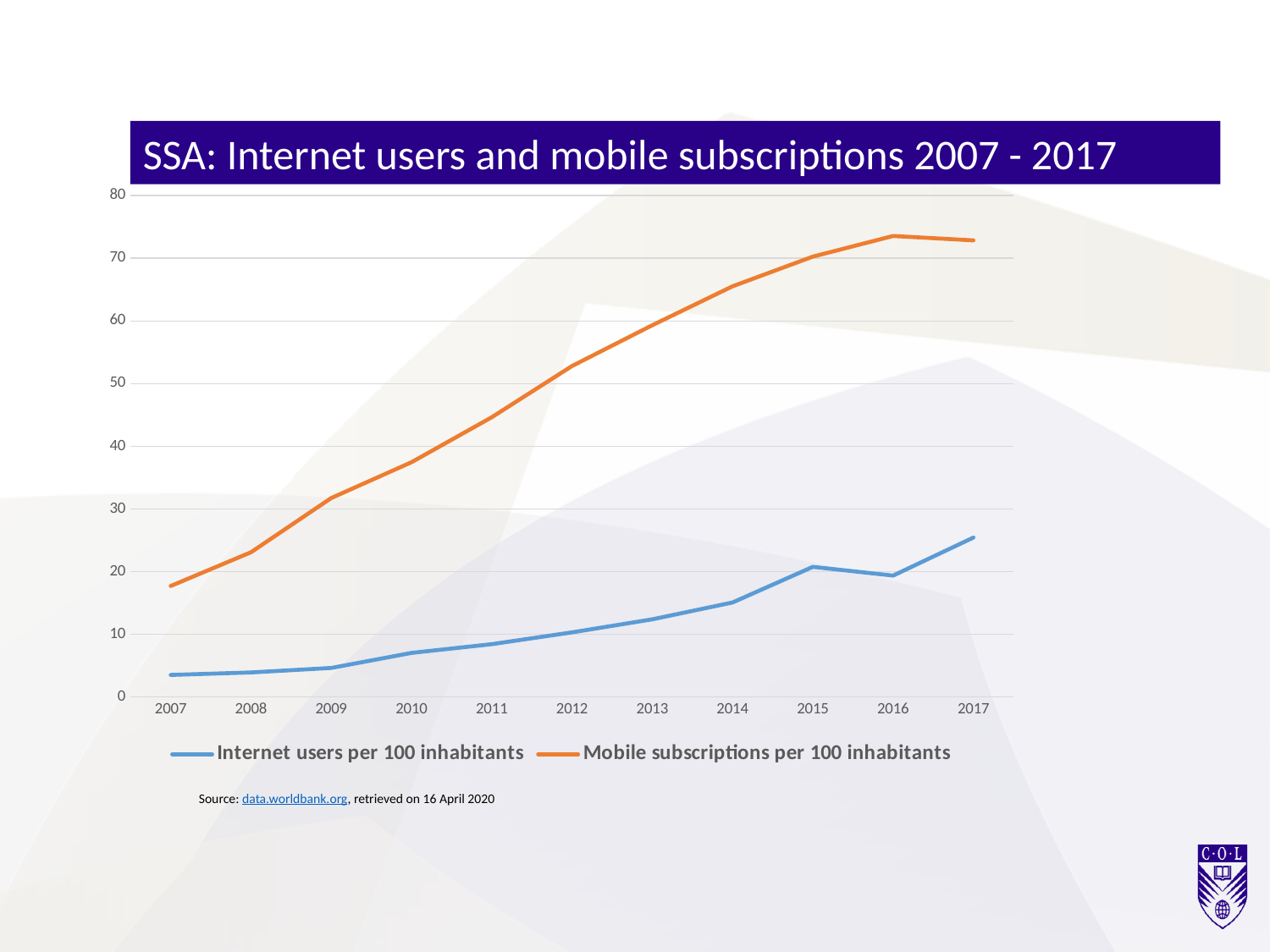
In which year is the value for Mobile subscriptions per 100 inhabitants highest? 2016 How many series does the legend list? 2 Is the value for Mobile subscriptions per 100 inhabitants in 2007 greater or less than 20? less Does the value for Internet users per 100 inhabitants generally rise or fall from 2007 to 2017? Rise How many years are shown on the x axis? 11 Is the value for Mobile subscriptions per 100 inhabitants in 2017 greater or less than 70? greater What is the title of the chart? SSA: Internet users and mobile subscriptions 2007 - 2017 In which year is the value for Internet users per 100 inhabitants lowest? 2007 Which series is plotted in orange? Mobile subscriptions per 100 inhabitants Is the value for Internet users per 100 inhabitants in 2017 greater or less than 30? less Which series has the larger value in 2012, Internet users per 100 inhabitants or Mobile subscriptions per 100 inhabitants? Mobile subscriptions per 100 inhabitants What type of chart is shown on the slide? Line chart